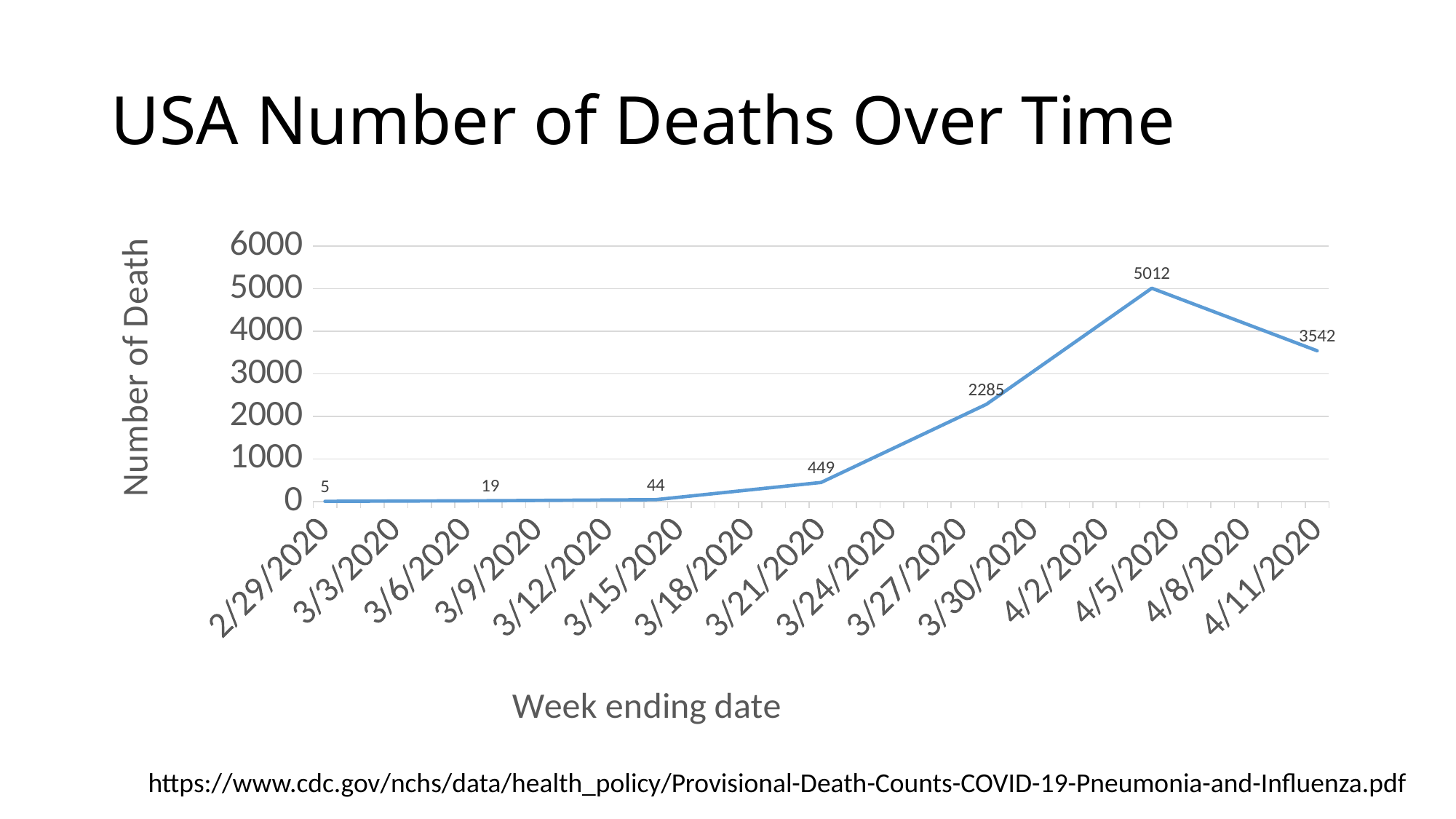
What is the highest number of deaths labeled on the chart? 5012 What is the difference between the peak value of 5012 and the final value of 3542? 1470 What is the title of the chart? USA Number of Deaths Over Time Is the value for the week ending 4/11/2020 greater or less than 3000? greater What is the number of deaths for the week ending 4/11/2020? 3542 What type of chart is shown on the slide? line chart What is the lowest number of deaths labeled on the chart? 5 What is the number of deaths for the week ending 2/29/2020? 5 What is the number of deaths for the week ending 3/21/2020? 449 What is the difference between the values for the weeks ending 3/21/2020 and 2/29/2020? 444 Which is larger, the value for the week ending 4/11/2020 or the value for the week ending 3/21/2020? 4/11/2020 How many data points are labeled on the line? 7